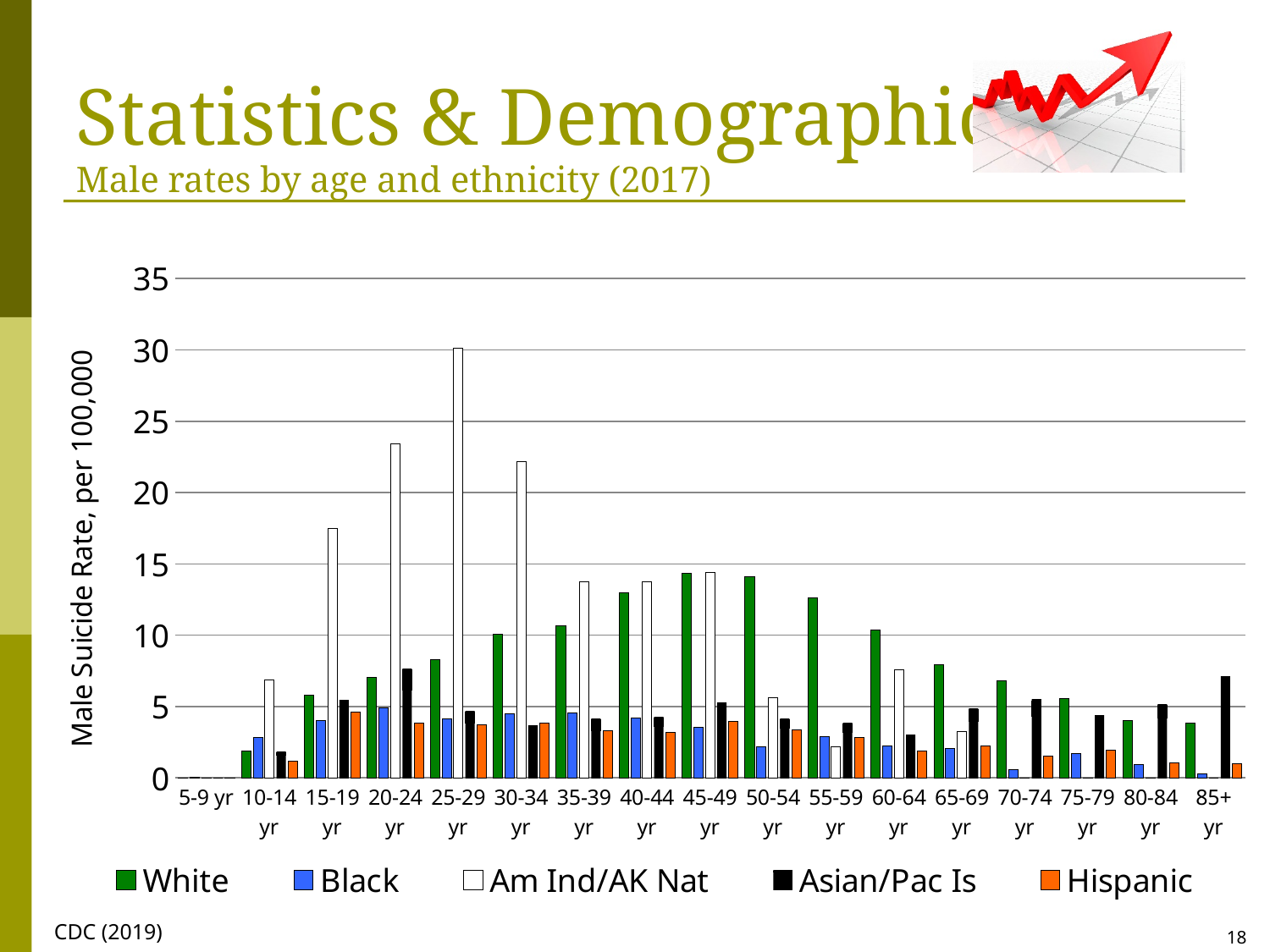
How many age groups are shown on the x axis? 17 For the 25-29 yr group, which is larger: the White value or the Am Ind/AK Nat value? Am Ind/AK Nat Is the Asian/Pac Is value for 85+ yr greater or less than 5? greater Which age group has the highest Am Ind/AK Nat value? 25-29 yr What is the label on the y axis? Male Suicide Rate, per 100,000 Do the White values rise or fall from 50-54 yr to 70-74 yr? Fall Is the White value for 85+ yr greater or less than 5? less How many series does the legend list? 5 Is the Am Ind/AK Nat value for 20-24 yr greater or less than 20? greater For the 40-44 yr group, which is larger: the White value or the Black value? White What kind of chart is shown on the slide? Bar chart